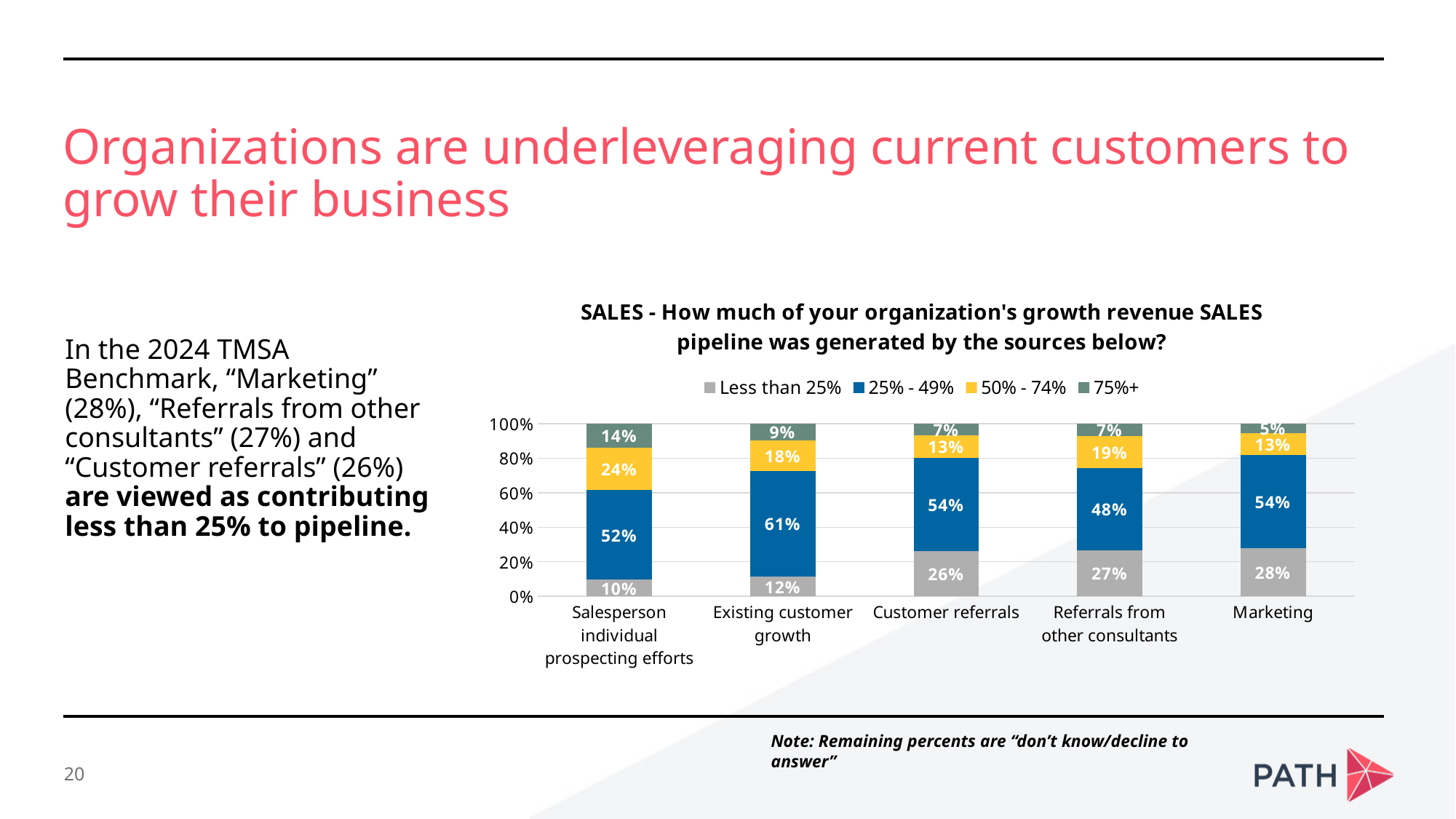
How many series does the legend list? 4 Which category has the highest value for the "Less than 25%" series? Marketing Which series is shown in yellow in the legend? 50% - 74% How many source categories are shown on the x axis? 5 What is the value of the "25% - 49%" series for Existing customer growth? 61% What is the value of the "75%+" series for Salesperson individual prospecting efforts? 14% Which is larger: the "50% - 74%" value for Salesperson individual prospecting efforts or for Existing customer growth? Salesperson individual prospecting efforts What is the difference between the "25% - 49%" values for Existing customer growth and Referrals from other consultants? 13% What is the value of the "Less than 25%" series for Marketing? 28% What type of chart is shown on the slide? Stacked bar chart Which category has the lowest value for the "75%+" series? Marketing What is the value of the "50% - 74%" series for Referrals from other consultants? 19%